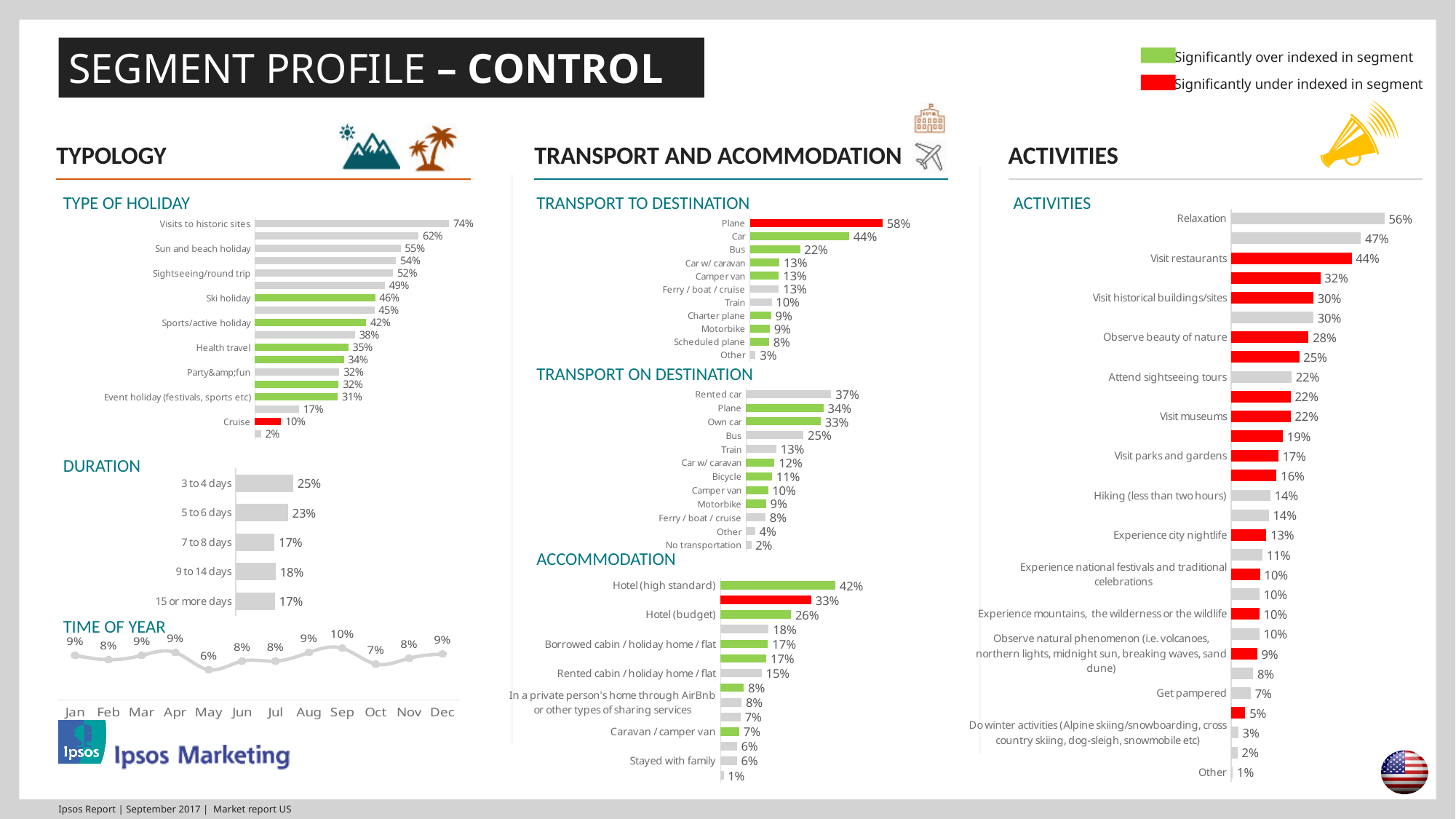
In the Transport on Destination chart, how many categories are shown? 12 In the Transport to Destination chart, what is the difference between Plane and Car? 14% In the Accommodation chart, what is the value for Hotel (budget)? 26% In the Duration chart, what is the difference between 3 to 4 days and 5 to 6 days? 2% In the Type of Holiday chart, what is the value for Visits to historic sites? 74% In the Transport on Destination chart, which category has the highest value? Rented car In the Transport to Destination chart, what is the value for Plane? 58% In the Type of Holiday chart, what is the value for Cruise? 10% In the Time of Year chart, which month has the lowest value? May In the Duration chart, which category has the highest value? 3 to 4 days What kind of chart is the Time of Year chart? Line chart In the Activities chart, which is larger, Relaxation or Visit restaurants? Relaxation